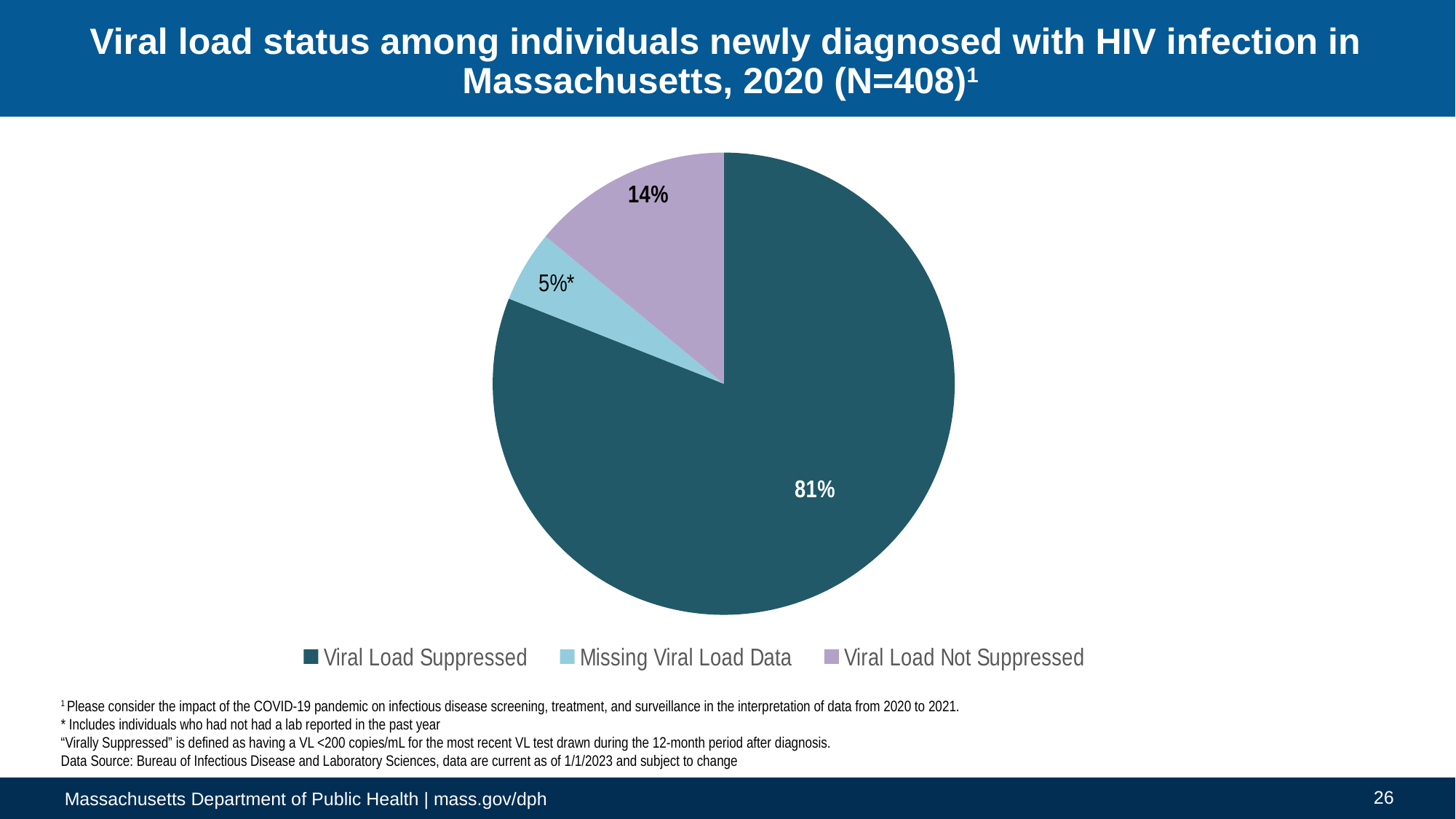
Which category has the smallest share of the pie? Missing Viral Load Data How many entries does the legend list? 3 Which is larger: the share for Viral Load Not Suppressed or the share for Missing Viral Load Data? Viral Load Not Suppressed What percentage of individuals had Missing Viral Load Data? 5%* What is the difference in percentage points between Viral Load Suppressed and Viral Load Not Suppressed? 67 What type of chart is shown on the slide? Pie chart What percentage of individuals had Viral Load Suppressed? 81% How many categories does the pie chart show? 3 Which legend entry is shown in light blue? Missing Viral Load Data Which category has the largest share of the pie? Viral Load Suppressed What percentage of individuals had Viral Load Not Suppressed? 14% What is the total N given in the chart title? 408